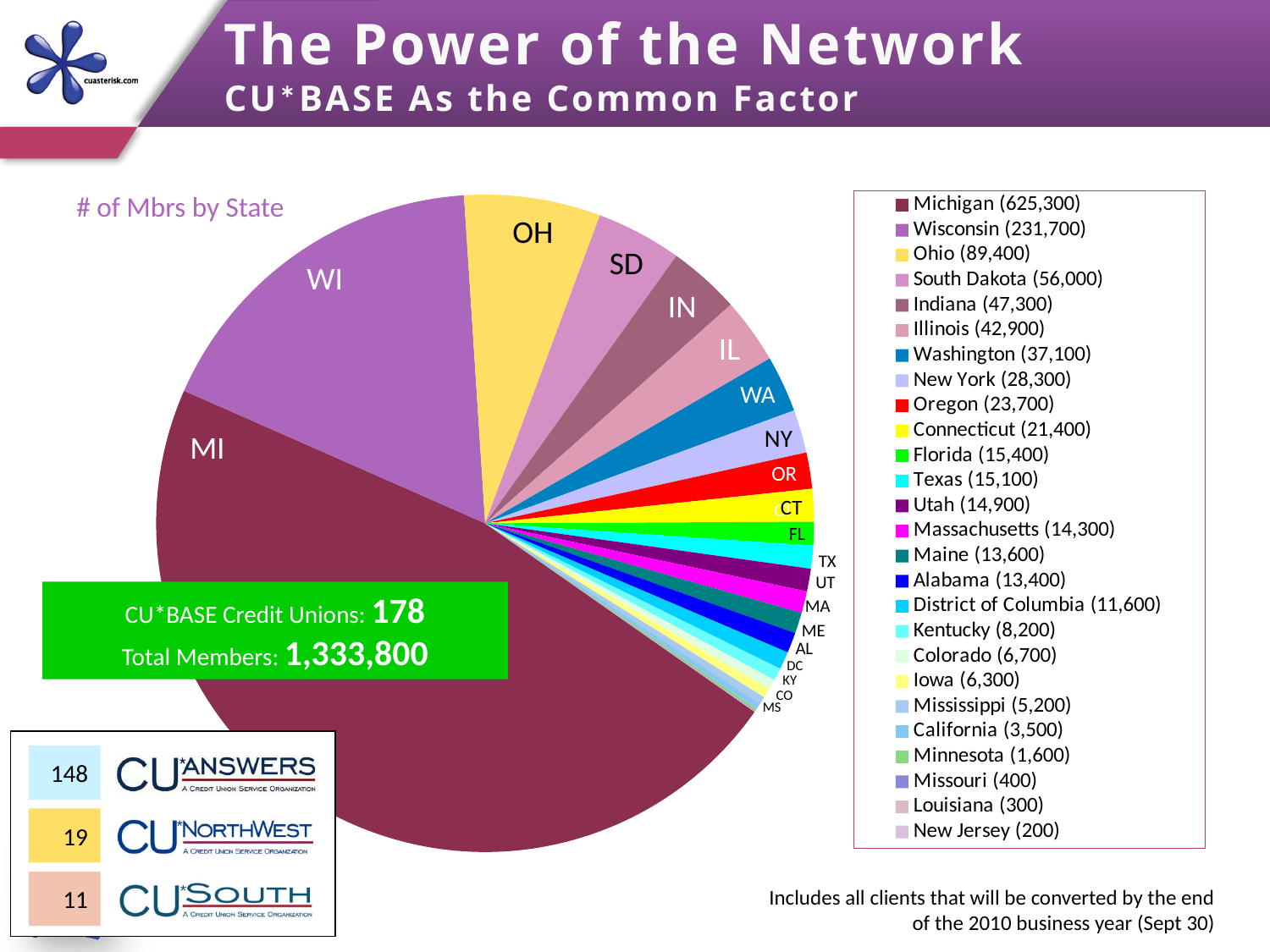
Which has more members, Oregon or Connecticut? Oregon How many members does the legend show for Washington? 37,100 How many members does the legend show for Michigan? 625,300 How many members does the legend show for Kentucky? 8,200 Which state has the smallest number of members? New Jersey What kind of chart is shown on the slide? pie chart What is the difference in members between Ohio and South Dakota? 33,400 How many states are listed in the chart legend? 26 How many members does the legend show for Wisconsin? 231,700 Which state has the largest number of members? Michigan What is the title of the chart? # of Mbrs by State What is the difference in members between Michigan and Wisconsin? 393,600